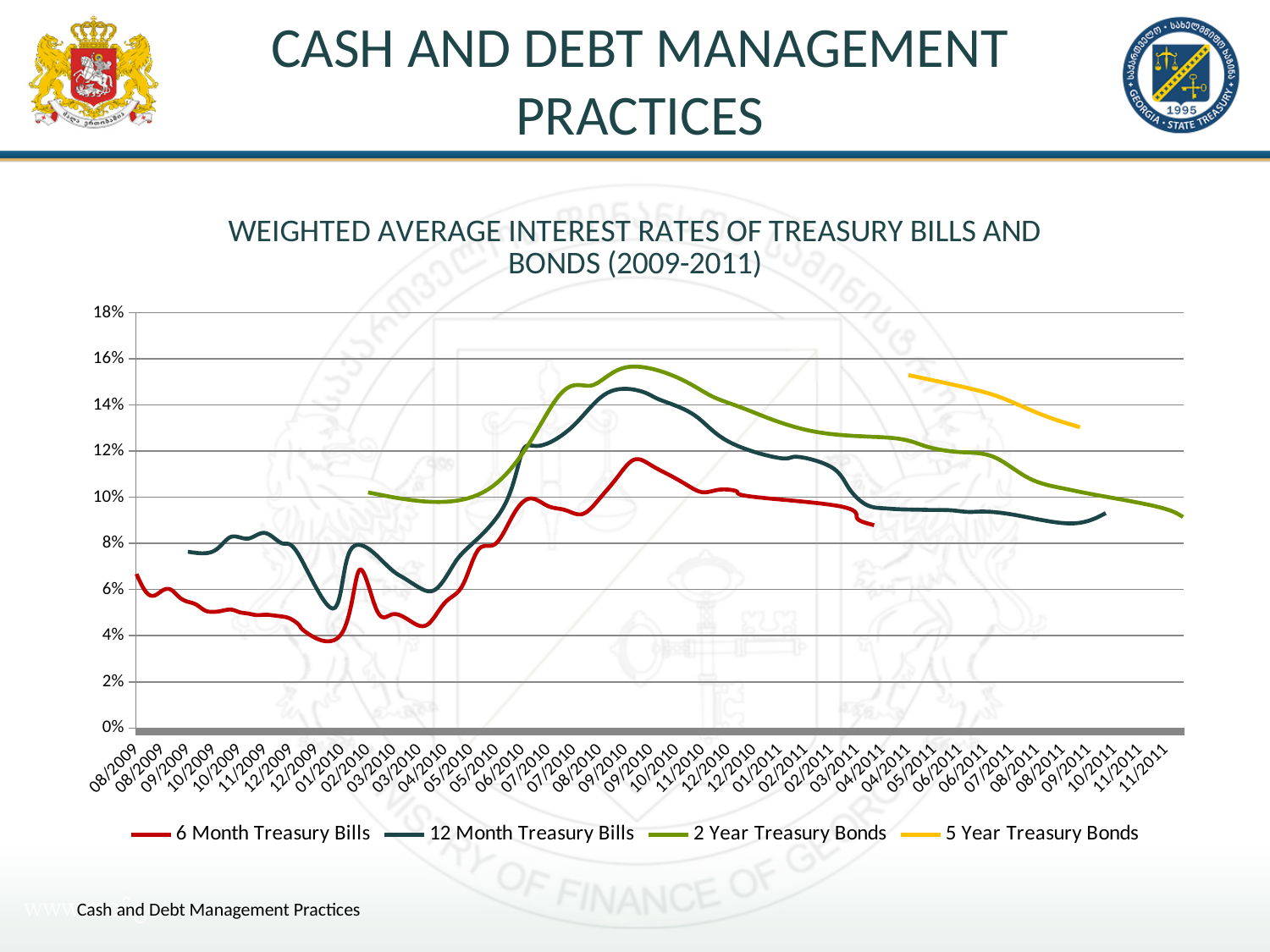
What kind of chart is shown on the slide? Line chart Does the 5 Year Treasury Bonds line rise or fall from 05/2011 to 09/2011? Fall Which colour is used for the 5 Year Treasury Bonds line? Yellow Is the value for 2 Year Treasury Bonds at 09/2010 greater or less than 14%? greater Is the value for 5 Year Treasury Bonds at 09/2011 greater or less than 12%? greater How many series does the legend list? 4 Is the value for 6 Month Treasury Bills at 04/2010 greater or less than 6%? less Which series has the lowest value at 09/2010? 6 Month Treasury Bills At 06/2011, which is larger: 2 Year Treasury Bonds or 12 Month Treasury Bills? 2 Year Treasury Bonds What is the title of the chart? WEIGHTED AVERAGE INTEREST RATES OF TREASURY BILLS AND BONDS (2009-2011) Does the 6 Month Treasury Bills line rise or fall from 04/2010 to 09/2010? Rise